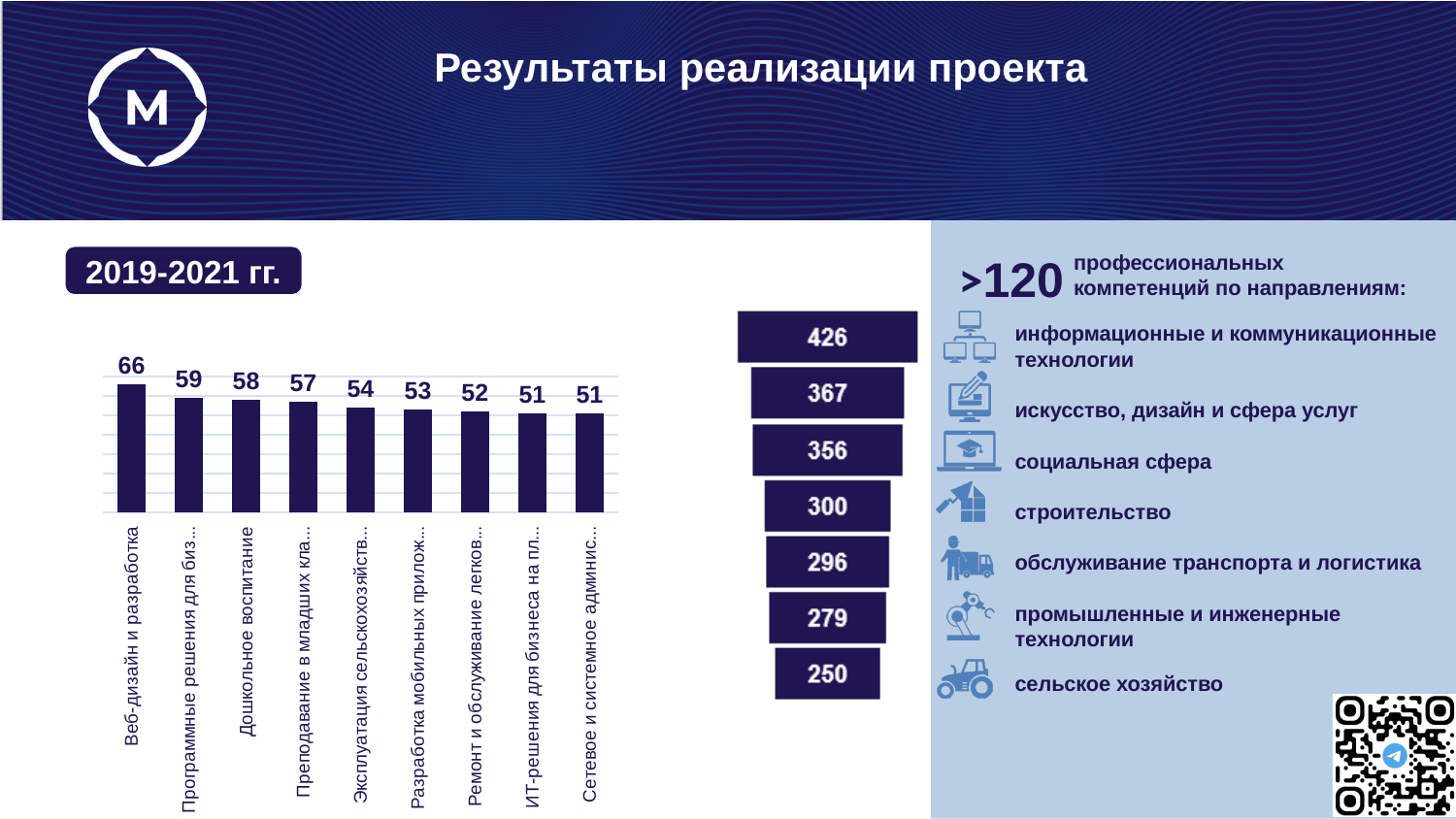
In the bar chart, which is larger: the value for 'Программные решения для биз...' or the value for 'Преподавание в младших кла...'? Программные решения для биз... In the bar chart, what is the value for Веб-дизайн и разработка? 66 How many bars are in the bar chart? 9 What type of chart is shown on the left of the slide under the heading 2019-2021 гг.? bar chart In the bar chart, what is the value for the category beginning 'Разработка мобильных прилож...'? 53 In the bar chart, which category has the highest value? Веб-дизайн и разработка In the bar chart, what is the difference between Веб-дизайн и разработка and Дошкольное воспитание? 8 How many boxes are in the funnel in the middle of the slide? 7 Do the values in the bar chart rise or fall from left to right? fall In the bar chart, what is the value for Дошкольное воспитание? 58 In the bar chart, what is the lowest value shown? 51 In the funnel of boxes in the middle of the slide, what is the value in the top box? 426